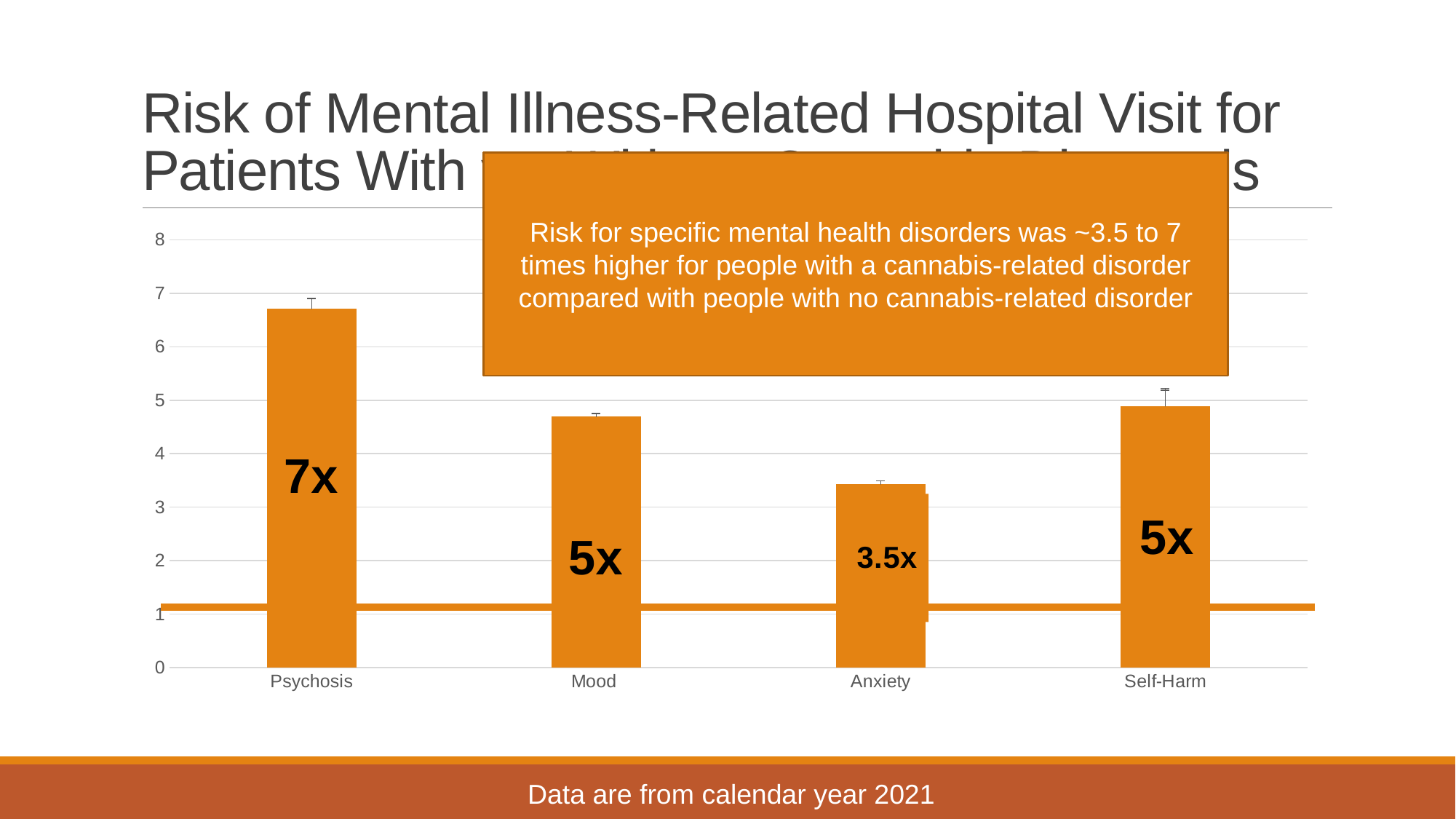
What label is printed on the Anxiety bar? 3.5x What kind of chart is shown on the slide? bar chart How many categories are plotted on the chart? 4 Is the value for Mood greater or less than 5? less Which category has the highest bar? Psychosis What label is printed on the Psychosis bar? 7x According to the footer, what calendar year are the data from? 2021 Which category has the lowest bar? Anxiety What label is printed on the Mood bar? 5x Is the value for Psychosis greater or less than 6? greater Which bar is taller, Psychosis or Mood? Psychosis What label is printed on the Self-Harm bar? 5x